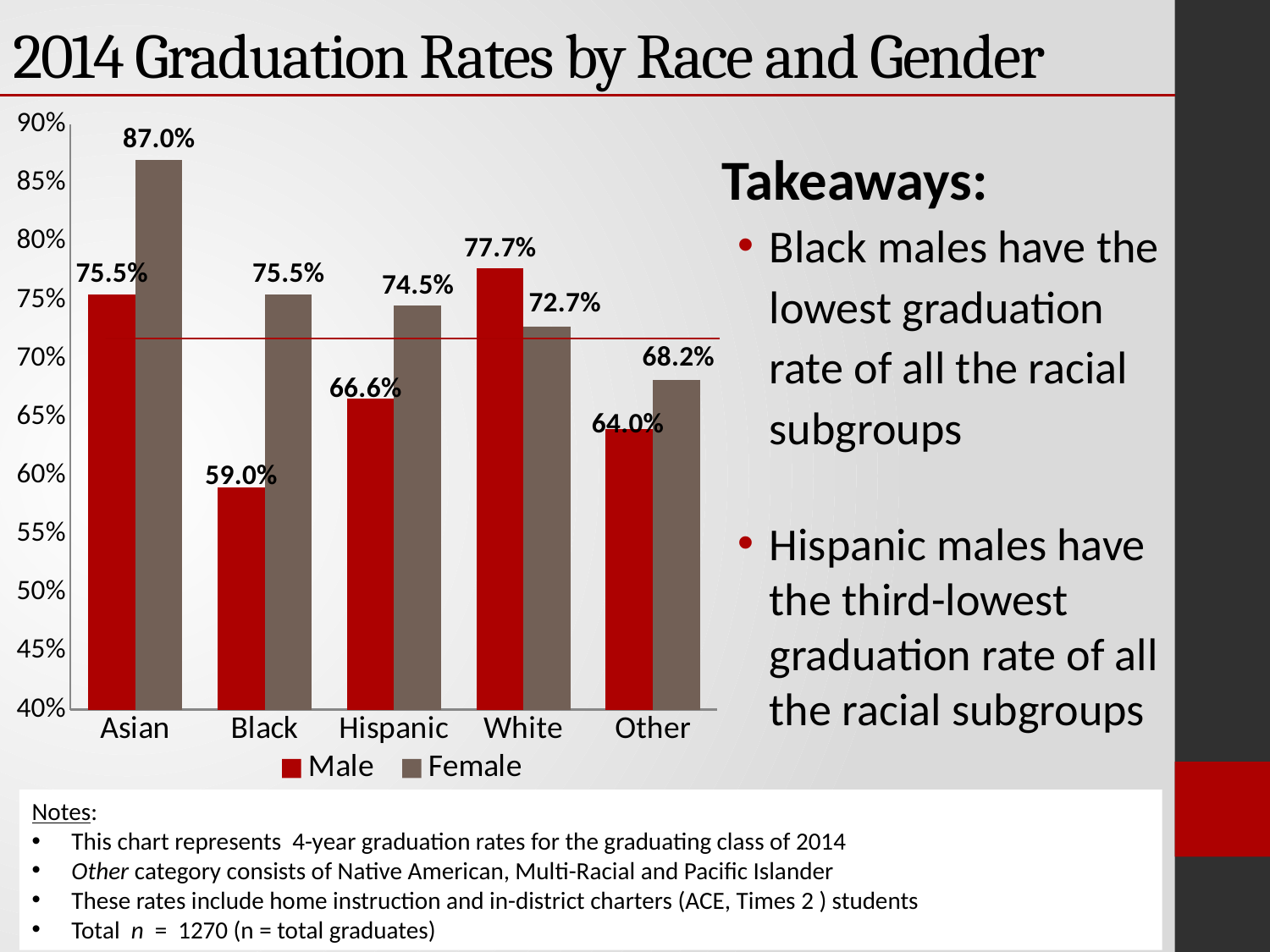
Which racial category has the lowest Male graduation rate? Black What colour are the Male bars in the chart? Red Which racial category has the highest Female graduation rate? Asian How many series does the legend list? 2 What is the difference between the Female and Male graduation rates for Black students? 16.5% What is the Male graduation rate for White students? 77.7% What is the Female graduation rate for Asian students? 87.0% Which is larger for White students, the Male or the Female graduation rate? Male What is the Female graduation rate for Other students? 68.2% What is the Male graduation rate for Black students? 59.0% What kind of chart is shown on the slide? Bar chart How many racial categories are shown on the x axis? 5